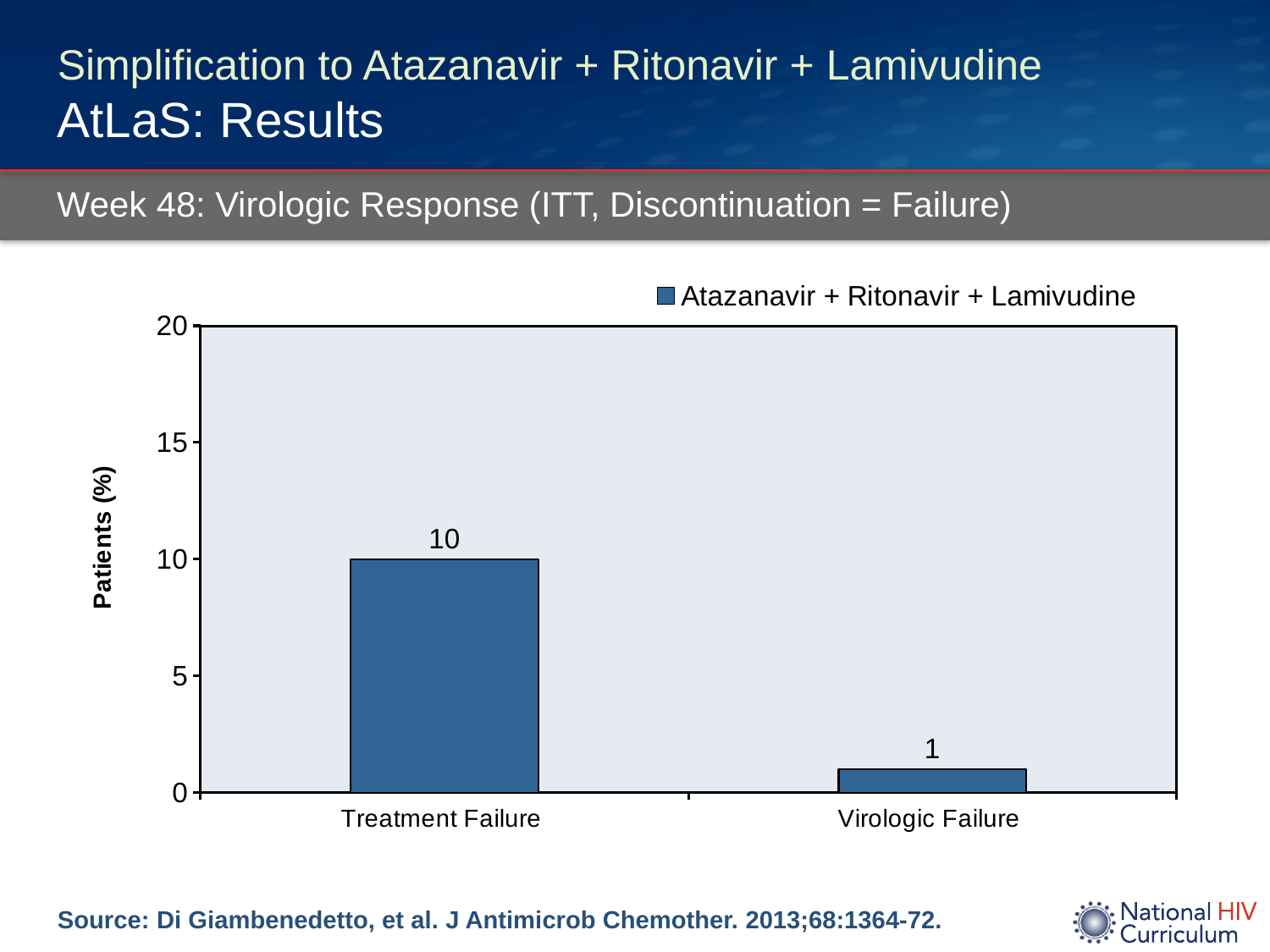
What is the value for Virologic Failure? 1 Which category has the highest value? Treatment Failure How many categories are shown on the x axis? 2 What series name is shown in the legend? Atazanavir + Ritonavir + Lamivudine What is the label of the y axis? Patients (%) Which is larger, the value for Treatment Failure or the value for Virologic Failure? Treatment Failure What kind of chart is shown on the slide? bar chart Is the value for Treatment Failure greater or less than 5? greater How many series does the legend list? 1 What is the difference between the values for Treatment Failure and Virologic Failure? 9 What is the value for Treatment Failure? 10 Which category has the lowest value? Virologic Failure